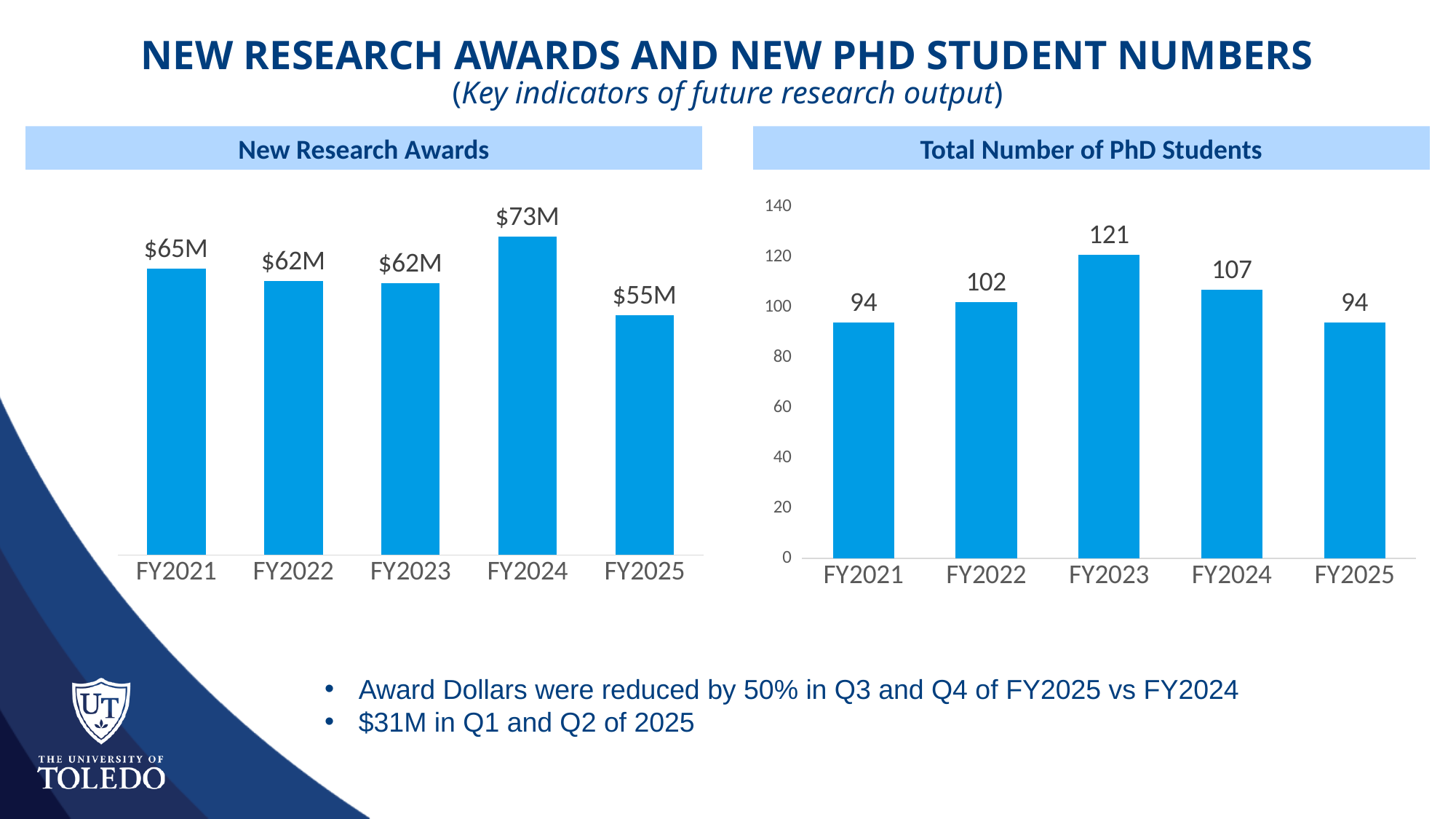
In the New Research Awards chart, what is the difference between FY2024 and FY2025? $18M In the New Research Awards chart, how many fiscal years are shown? 5 In the Total Number of PhD Students chart, do the values rise or fall from FY2023 to FY2025? fall In the New Research Awards chart, which fiscal year has the lowest value? FY2025 In the Total Number of PhD Students chart, which fiscal year has the highest value? FY2023 What kind of chart is the Total Number of PhD Students chart? bar chart In the Total Number of PhD Students chart, what is the value for FY2023? 121 What is the title of the chart on the left side of the slide? New Research Awards In the New Research Awards chart, is the value for FY2021 larger or smaller than the value for FY2022? larger In the New Research Awards chart, what is the value for FY2024? $73M In the Total Number of PhD Students chart, what is the difference between FY2023 and FY2024? 14 In the Total Number of PhD Students chart, is the value for FY2024 greater or less than 100? greater